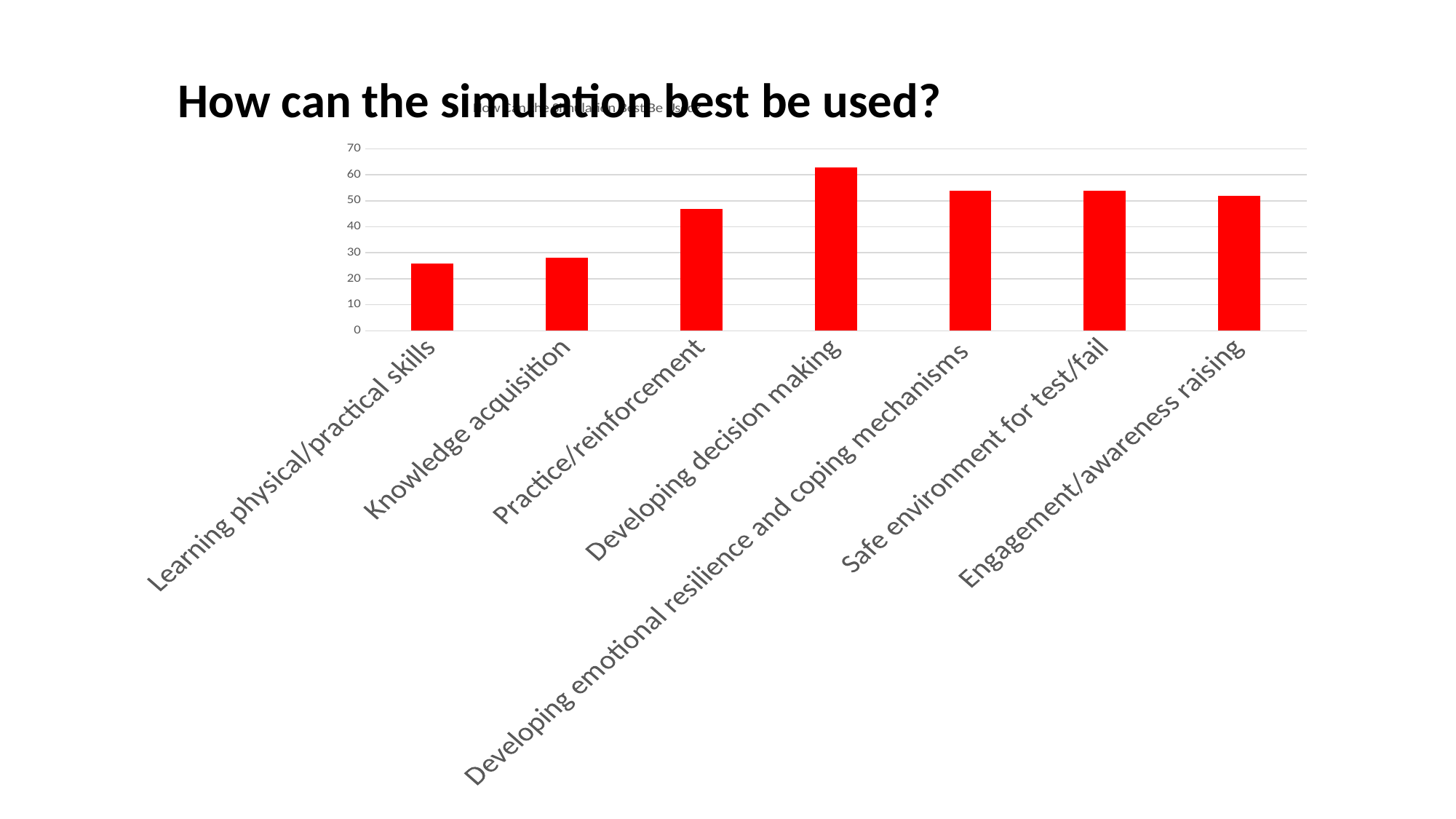
Which is larger, the value for Knowledge acquisition or the value for Engagement/awareness raising? Engagement/awareness raising Is the value for Developing emotional resilience and coping mechanisms greater or less than 60? less Is the value for Practice/reinforcement greater or less than 40? greater Which is larger, the value for Practice/reinforcement or the value for Developing decision making? Developing decision making Which category has the highest value in the chart? Developing decision making Is the value for Developing decision making greater or less than 60? greater What colour are the bars in the chart? red What kind of chart is shown on the slide? bar chart How many categories are shown on the x axis of the chart? 7